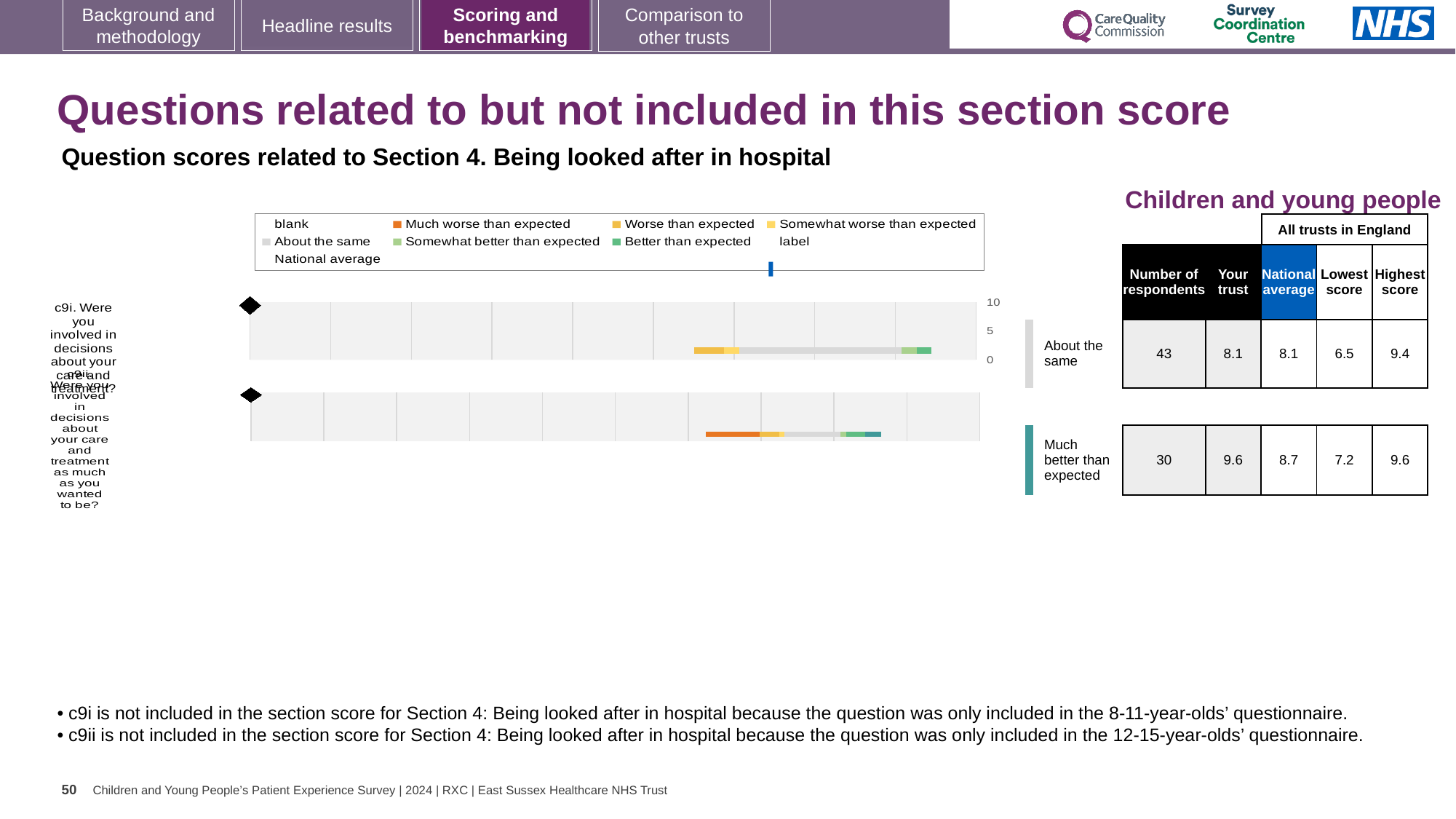
How many respondents answered question c9i? 43 What is the difference between the trust's score and the national average for c9ii? 0.9 What is the national average score for c9ii? 8.7 What benchmark category label is shown next to the c9ii bar? Much better than expected What type of chart is used to show the question scores for c9i and c9ii? bar chart Which question has the higher 'Your trust' score, c9i or c9ii? c9ii What is the lowest score across all trusts in England for c9ii? 7.2 What is the 'Your trust' score for c9ii (Were you involved in decisions about your care and treatment as much as you wanted to be?)? 9.6 What is the difference between the highest and lowest scores across all trusts in England for c9i? 2.9 What is the 'Your trust' score for c9i (Were you involved in decisions about your care and treatment?)? 8.1 What is the highest score across all trusts in England for c9i? 9.4 How many questions (bars) are plotted in the chart? 2